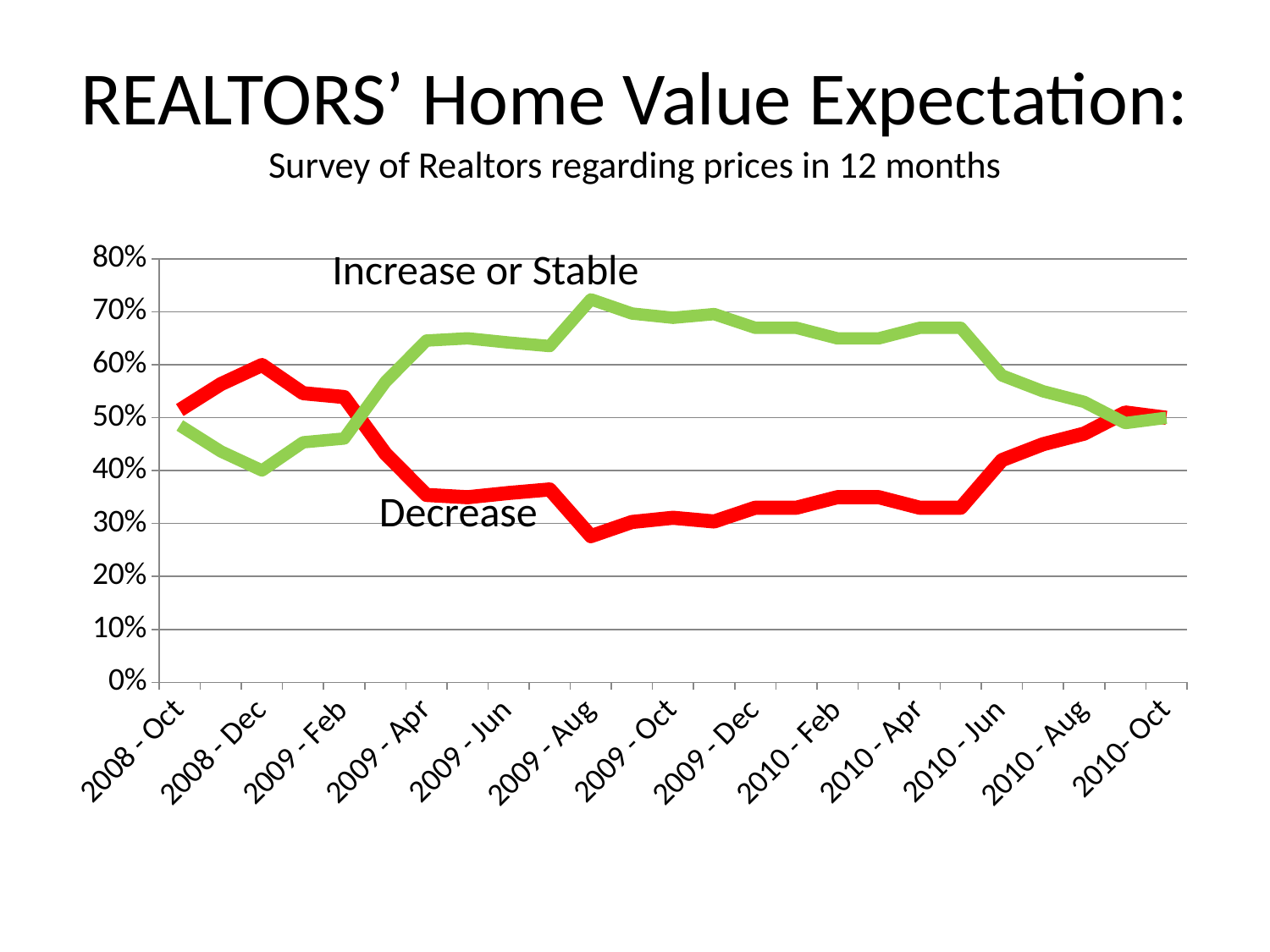
At which month does the 'Increase or Stable' series reach its lowest value? 2008 - Dec How many data series are plotted on the chart? 2 What colour is the 'Decrease' line? red From 2009 - Aug to 2010 - Oct, does the 'Decrease' series generally rise or fall? rise At which month does the 'Decrease' series reach its lowest value? 2009 - Aug Is the value for 'Increase or Stable' at 2009 - Aug greater or less than 70%? greater At which month does the 'Increase or Stable' series reach its highest value? 2009 - Aug At 2008 - Dec, which series has the higher value, 'Increase or Stable' or 'Decrease'? Decrease What kind of chart is shown on the slide? line chart Is the value for 'Decrease' at 2009 - Apr greater or less than 40%? less What is the subtitle of the chart? Survey of Realtors regarding prices in 12 months Is the value for 'Decrease' at 2009 - Aug greater or less than 30%? less